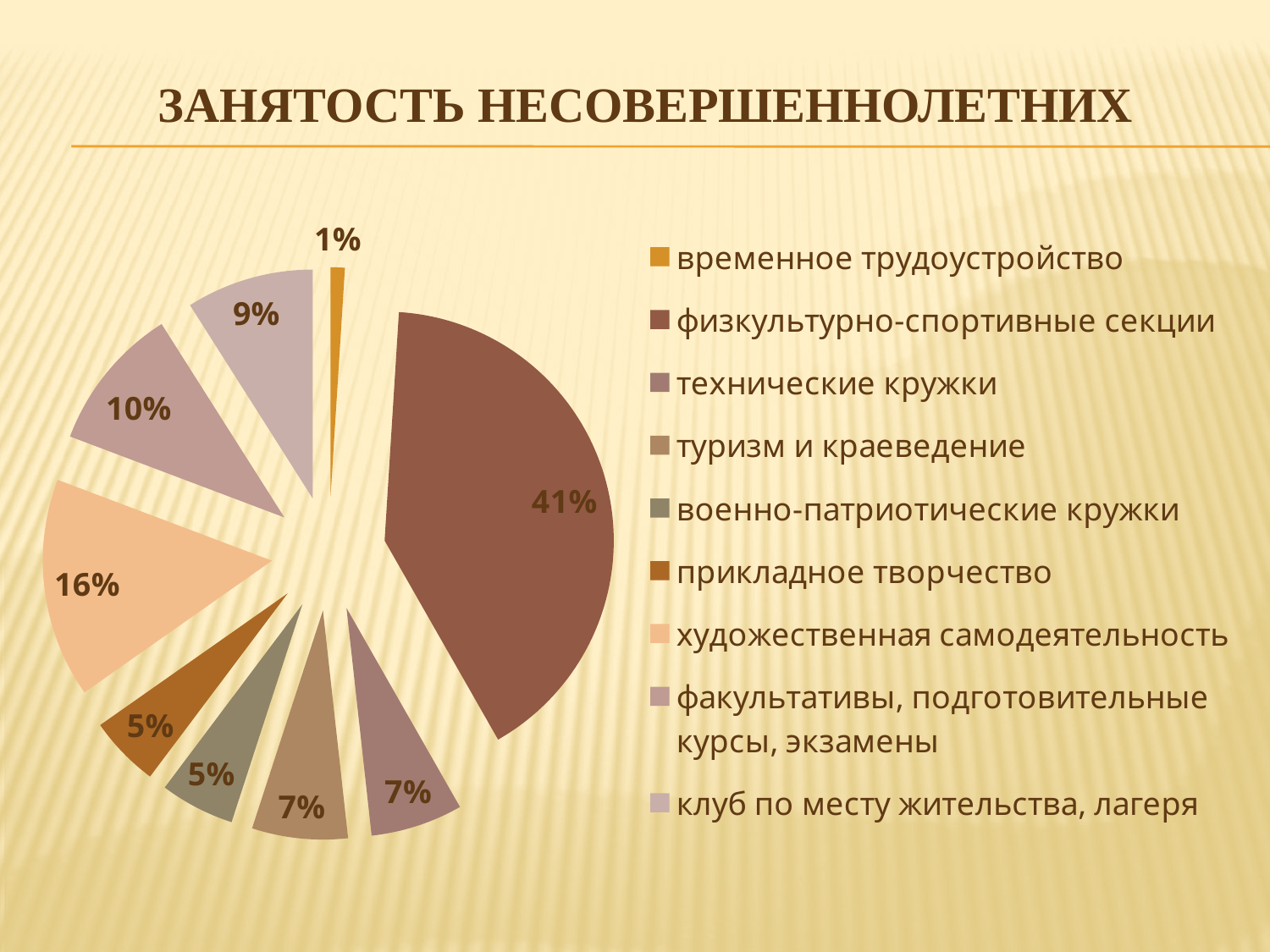
What is the title of the slide? ЗАНЯТОСТЬ НЕСОВЕРШЕННОЛЕТНИХ What kind of chart is shown on the slide? pie chart How many categories does the pie chart show? 9 Which category has the largest slice of the pie? физкультурно-спортивные секции What percentage is shown for временное трудоустройство? 1% What percentage is shown for факультативы, подготовительные курсы, экзамены? 10% What share of the pie does физкультурно-спортивные секции take? 41% What is the value shown for художественная самодеятельность? 16% What is the difference between the shares of физкультурно-спортивные секции and художественная самодеятельность? 25% Which category has the smallest slice of the pie? временное трудоустройство Which is larger, the share for факультативы, подготовительные курсы, экзамены or the share for клуб по месту жительства, лагеря? факультативы, подготовительные курсы, экзамены What is the value for клуб по месту жительства, лагеря? 9%